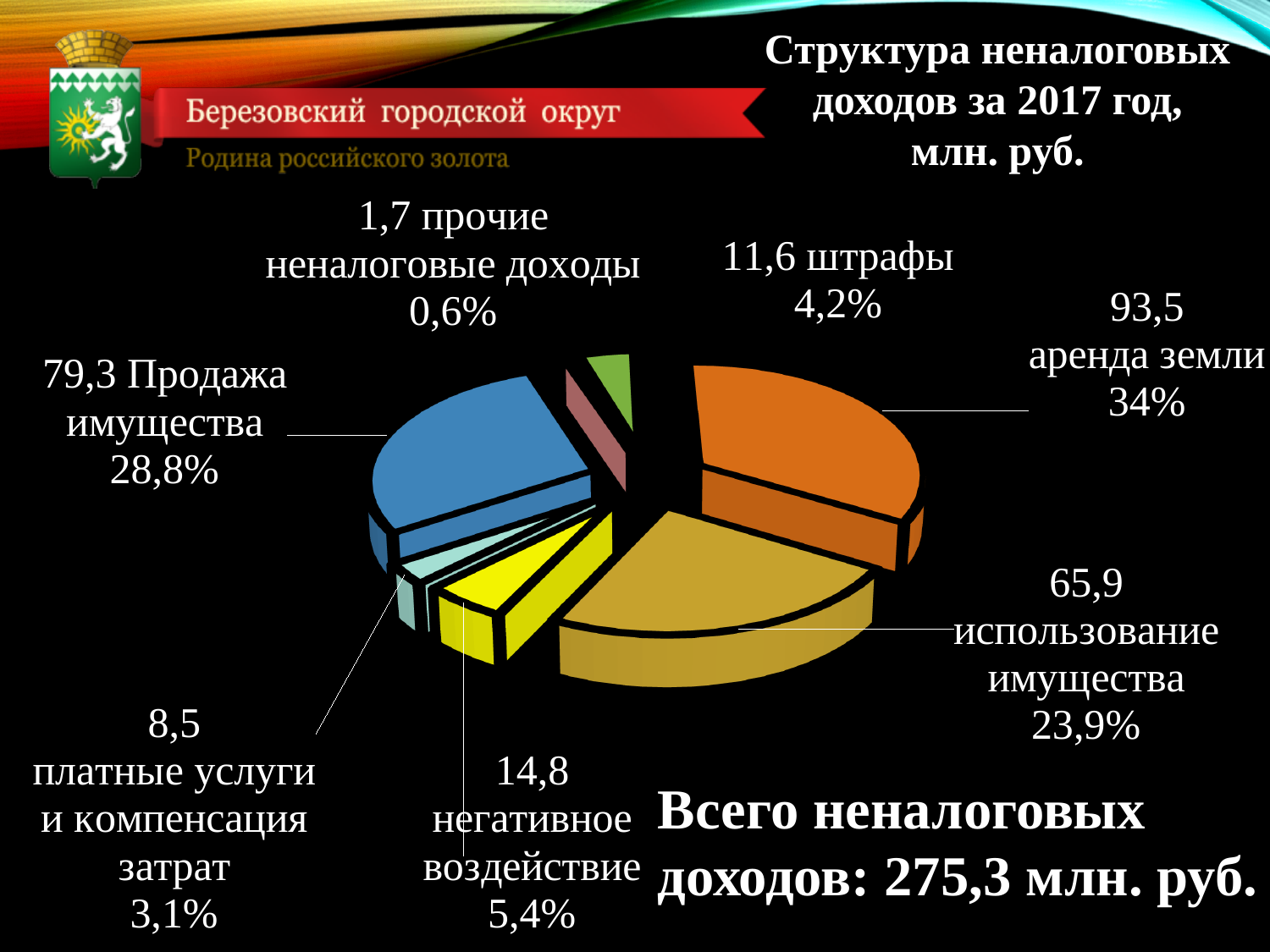
Сколько категорий неналоговых доходов показано на круговой диаграмме? 7 Какая категория имеет наименьшую долю в структуре неналоговых доходов? прочие неналоговые доходы Какова величина доходов от штрафов, млн. руб.? 11,6 Какова величина доходов от аренды земли, млн. руб.? 93,5 Что больше: доходы от негативного воздействия или доходы от платных услуг и компенсации затрат? негативное воздействие Как называется диаграмма на слайде? Структура неналоговых доходов за 2017 год, млн. руб. Какой тип диаграммы показан на слайде? круговая диаграмма Какая категория имеет наибольшую долю в структуре неналоговых доходов? аренда земли Какую долю занимает использование имущества в структуре неналоговых доходов? 23,9% Какую долю в структуре неналоговых доходов занимает продажа имущества? 28,8% Каков общий объём неналоговых доходов за 2017 год? 275,3 млн. руб. На сколько млн. руб. доходы от аренды земли превышают доходы от использования имущества? 27,6